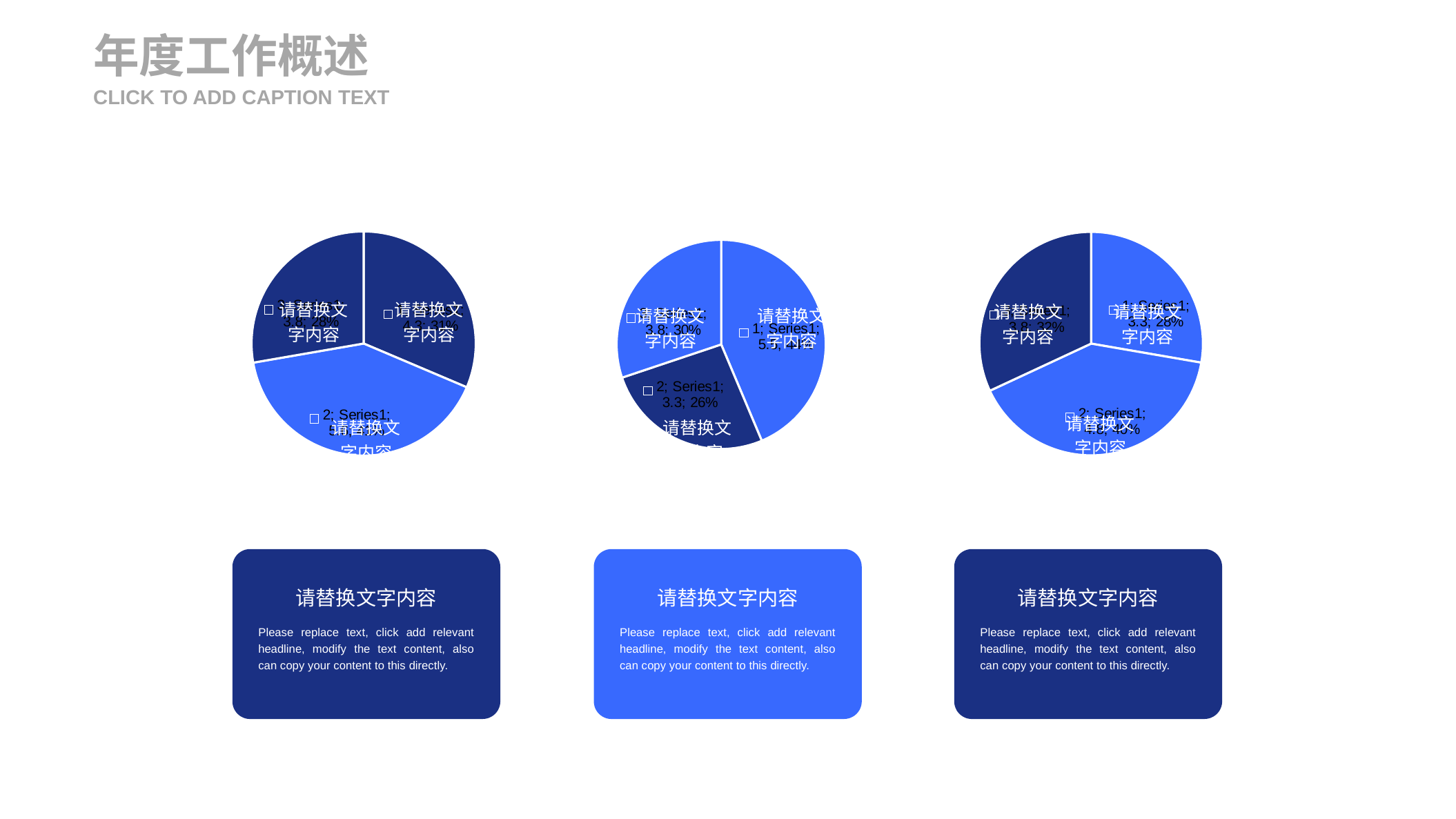
In the left pie chart, what value is shown for slice 1? 4.3 In the right pie chart, what percentage is shown for slice 1? 28% In the middle pie chart, what value is shown for slice 2? 3.3 In the middle pie chart, what percentage is shown for slice 2? 26% In the left pie chart, which is larger, slice 1 or slice 3? slice 1 In the middle pie chart, which slice is the smallest? slice 2 In the left pie chart, which slice is the largest? slice 2 In the middle pie chart, what is the difference in percentage points between slice 3 and slice 2? 4 What kind of chart is the left chart on the slide? pie chart In the left pie chart, what percentage is shown for slice 3? 28% How many slices does the middle pie chart have? 3 In the middle pie chart, what percentage is shown for slice 3? 30%